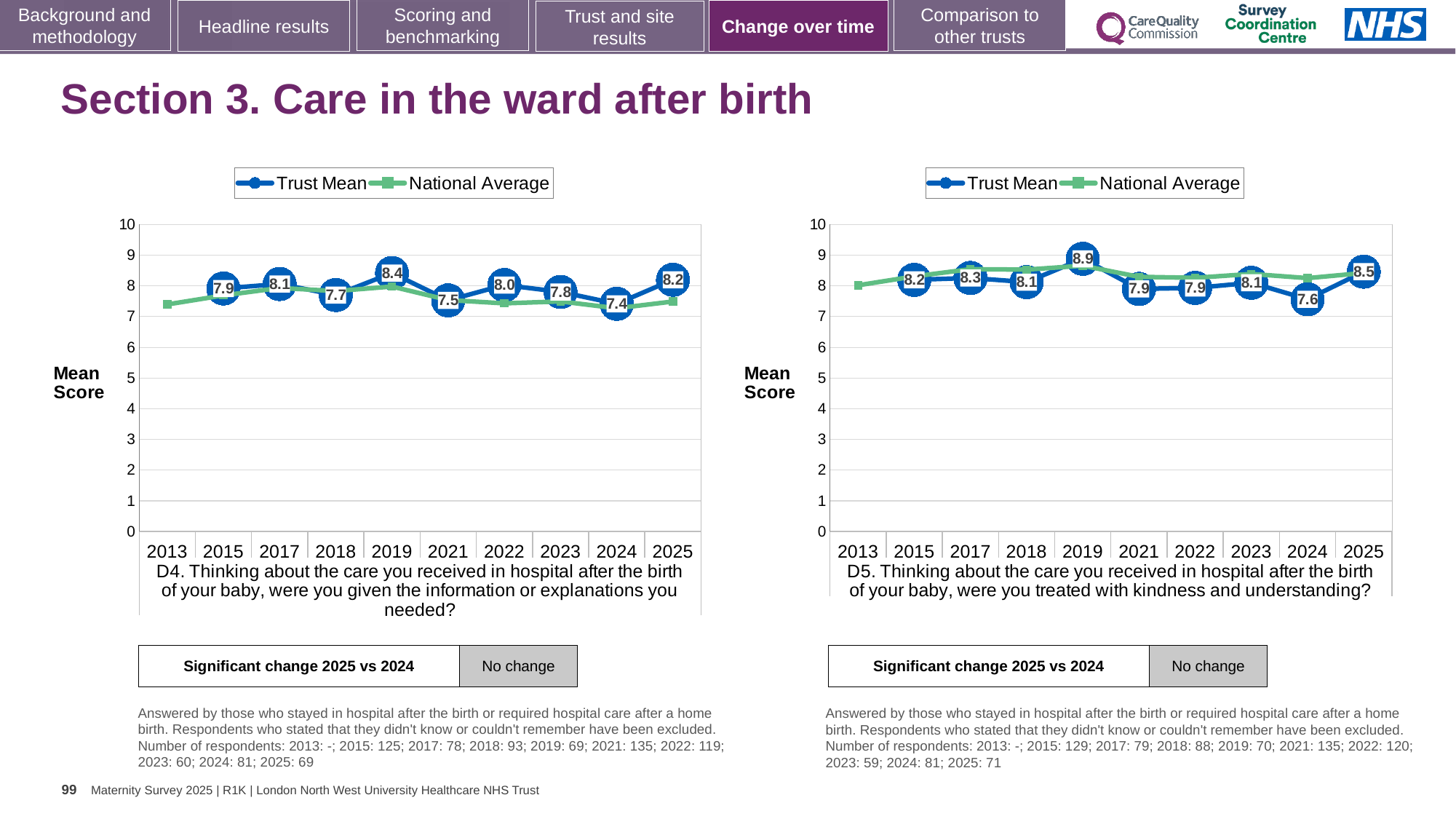
What does the 'Significant change 2025 vs 2024' box below the D4 chart (left) say? No change In the D5 chart (right), which year has the lowest Trust Mean? 2024 What kind of chart is the D5 chart (right)? Line chart How many years are shown on the x axis of the D5 chart (right)? 10 In the D4 chart (left), which year has the highest Trust Mean? 2019 In the D4 chart (left), what is the Trust Mean for 2019? 8.4 In the D5 chart (right), did the Trust Mean rise or fall from 2024 to 2025? Rise In the D5 chart (right), which is larger: the Trust Mean for 2019 or for 2025? 2019 How many series does the legend of the D4 chart (left) list? 2 In the D4 chart (left), is the National Average for 2013 greater or less than 8? less In the D5 chart (right), what is the Trust Mean for 2024? 7.6 In the D4 chart (left), what is the difference between the Trust Mean in 2025 and in 2024? 0.8